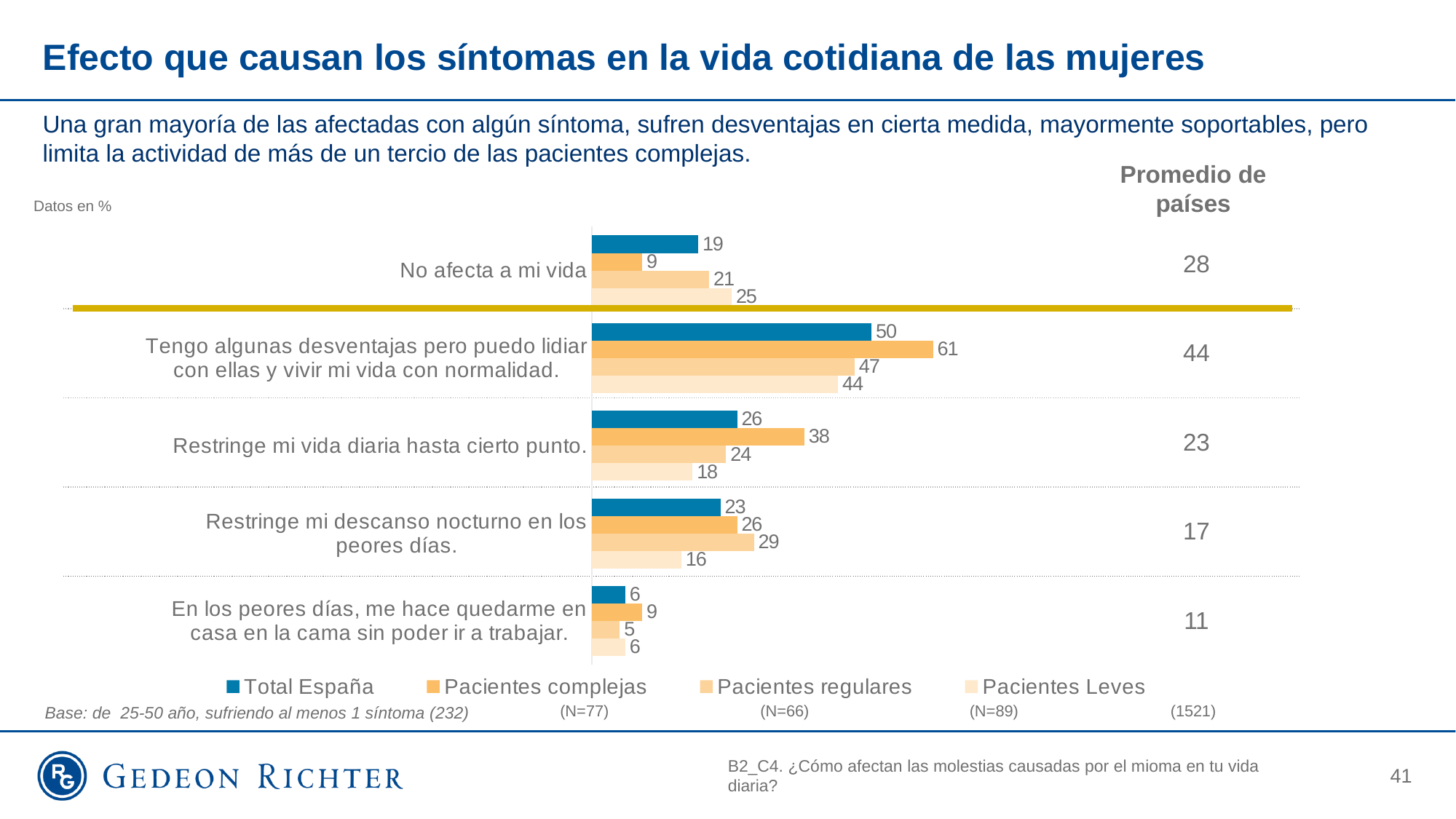
What is the 'Promedio de países' value for 'Restringe mi descanso nocturno en los peores días.'? 17 What is the difference between Pacientes complejas and Total España for 'Restringe mi vida diaria hasta cierto punto.'? 12 Which category has the highest value for Total España? Tengo algunas desventajas pero puedo lidiar con ellas y vivir mi vida con normalidad. What is the value for Pacientes Leves for 'Restringe mi vida diaria hasta cierto punto.'? 18 What is the value for Pacientes complejas for 'Tengo algunas desventajas pero puedo lidiar con ellas y vivir mi vida con normalidad.'? 61 How many categories are shown on the chart? 5 What kind of chart is shown on the slide? Bar chart For 'No afecta a mi vida', which is larger: Pacientes complejas or Pacientes Leves? Pacientes Leves What is the value for Total España for 'No afecta a mi vida'? 19 What is the value for Pacientes regulares for 'Restringe mi descanso nocturno en los peores días.'? 29 How many series does the legend list? 4